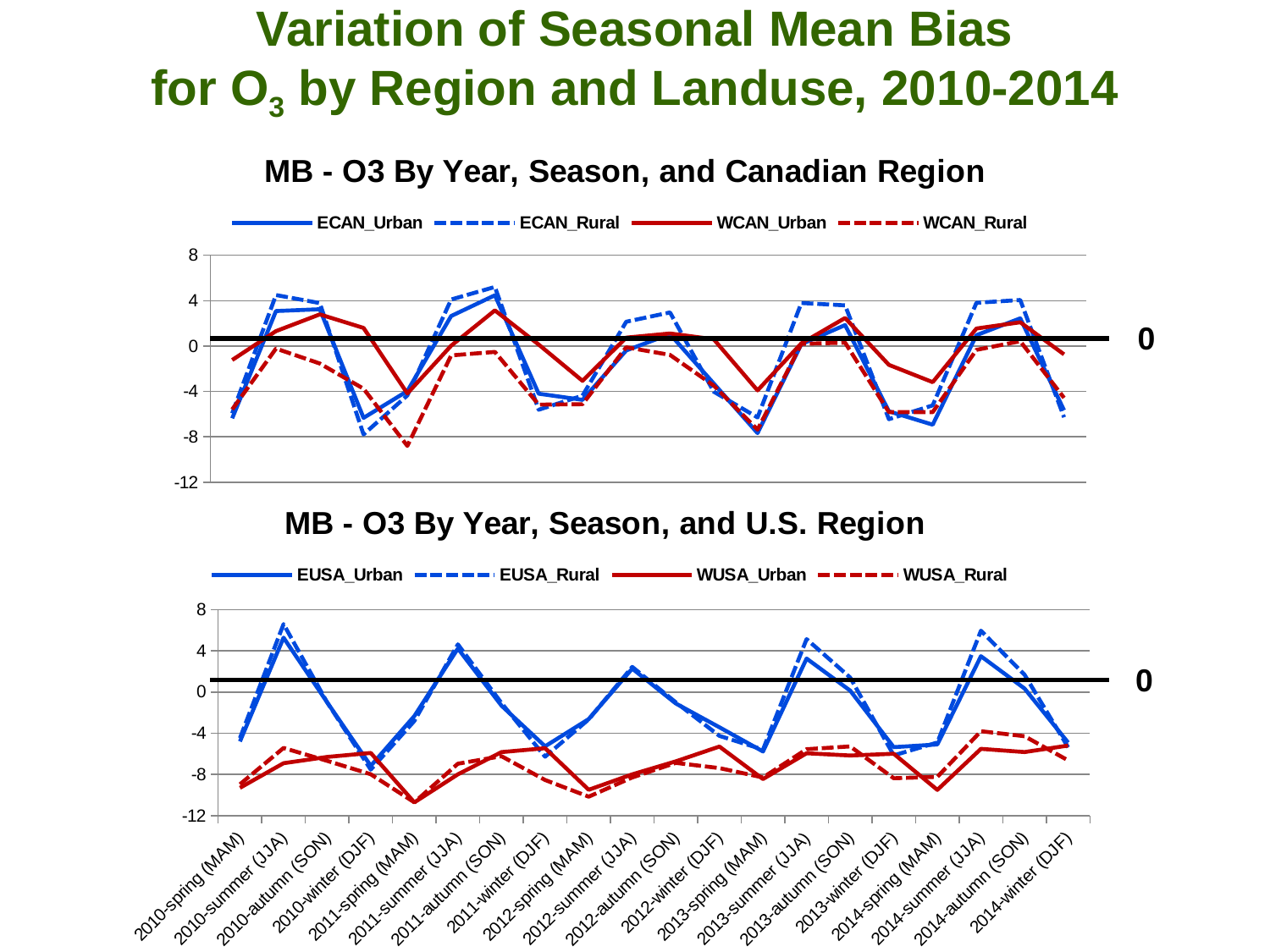
How many series does the legend of the top chart (Canadian Region) list? 4 In the bottom chart (U.S. Region), is the value for EUSA_Rural at 2010-summer (JJA) greater or less than 4? greater How many season categories are shown along the x axis of the bottom chart (U.S. Region)? 20 In the bottom chart (U.S. Region), which is larger at 2010-summer (JJA): EUSA_Rural or WUSA_Rural? EUSA_Rural In the bottom chart (U.S. Region), which series reaches the highest value on the chart? EUSA_Rural In the top chart (Canadian Region), is the value for ECAN_Urban at 2010-winter (DJF) greater or less than -4? less What kind of chart is the top chart, 'MB - O3 By Year, Season, and Canadian Region'? Line chart In the top chart (Canadian Region), which legend entries are drawn with dashed lines? ECAN_Rural and WCAN_Rural In the top chart (Canadian Region), is the value for WCAN_Urban at 2010-autumn (SON) greater or less than 0? greater What is the title of the bottom chart? MB - O3 By Year, Season, and U.S. Region